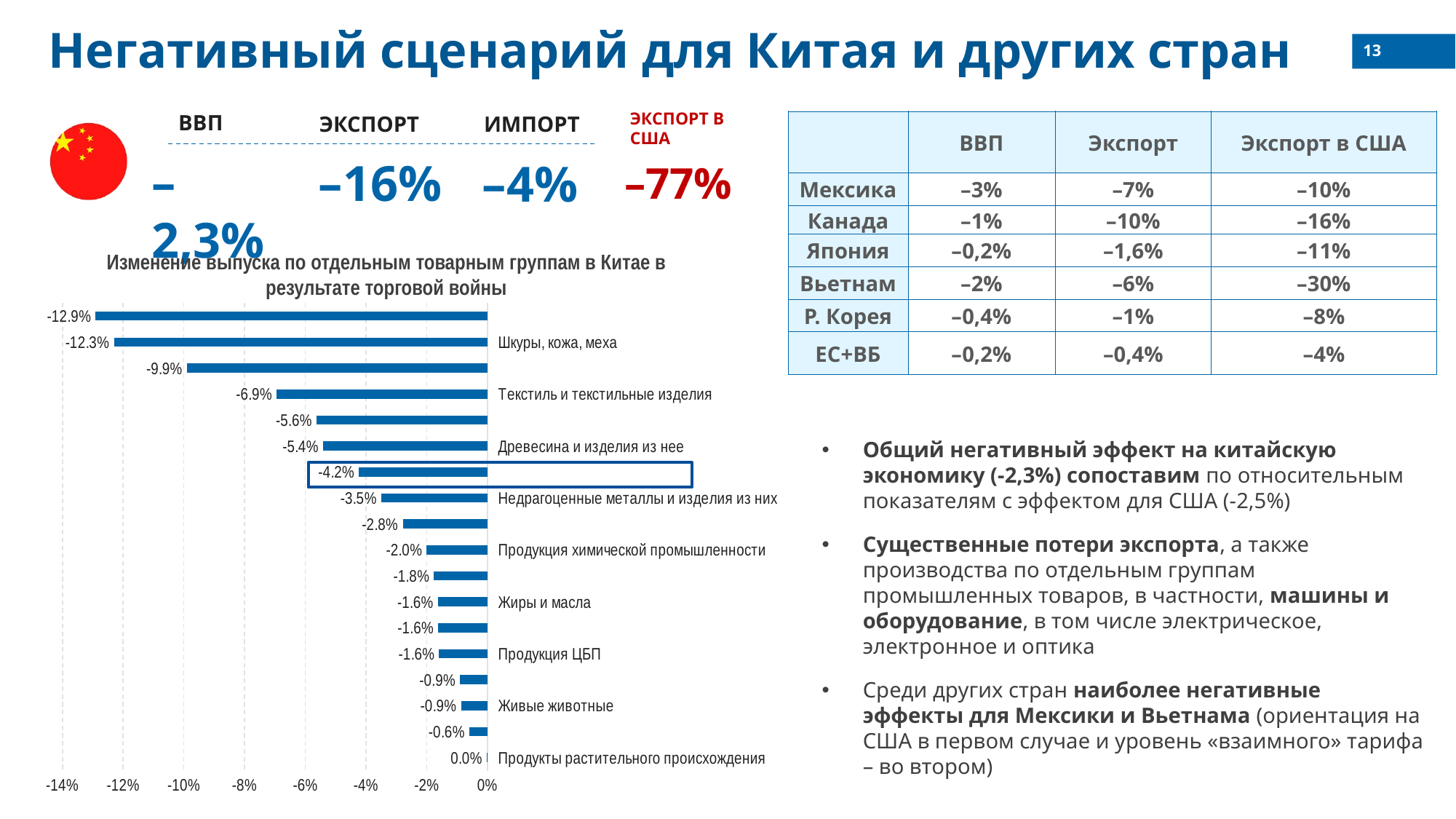
What kind of chart is shown on the slide? Bar chart What is the value for Живые животные? -0.9% What is the value shown for the longest bar in the chart? -12.9% What is the value for Недрагоценные металлы и изделия из них? -3.5% What is the value for Продукция химической промышленности? -2.0% What is the difference between the values for Шкуры, кожа, меха and Текстиль и текстильные изделия? 5.4 percentage points What is the value for Текстиль и текстильные изделия? -6.9% Which labeled category has the smallest change in output? Продукты растительного происхождения How many bars are plotted in the chart? 18 What is the value for Шкуры, кожа, меха? -12.3% Which has a larger decline, Древесина и изделия из нее or Продукция ЦБП? Древесина и изделия из нее What is the value for Древесина и изделия из нее? -5.4%